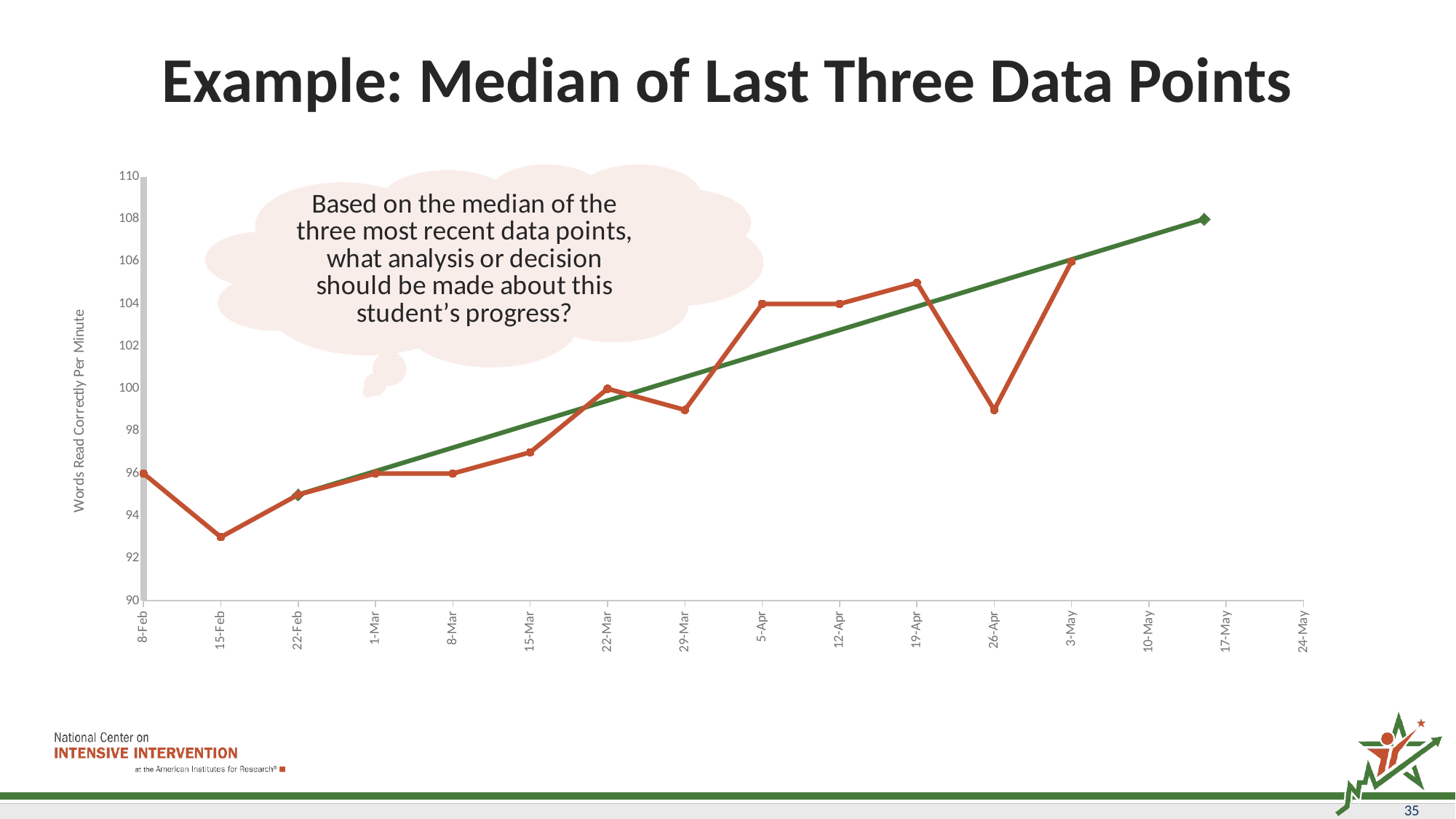
What kind of chart is shown on the slide? line chart How many data points are plotted on the orange student data line? 13 On which date is the orange data line at its lowest value? 15-Feb What is the value of the orange data line on 22-Mar? 100 Is the value of the orange data line on 26-Apr greater or less than 100? less What is the value of the orange data line on 3-May? 106 Which has a higher value on the orange data line, 5-Apr or 26-Apr? 5-Apr Is the value of the orange data line on 19-Apr greater or less than 104? greater What is the value of the orange data line on 8-Feb? 96 What is the difference between the orange data line's value on 3-May and on 8-Feb? 10 What is the y-axis label of the chart? Words Read Correctly Per Minute What value does the green goal line reach at its right endpoint? 108